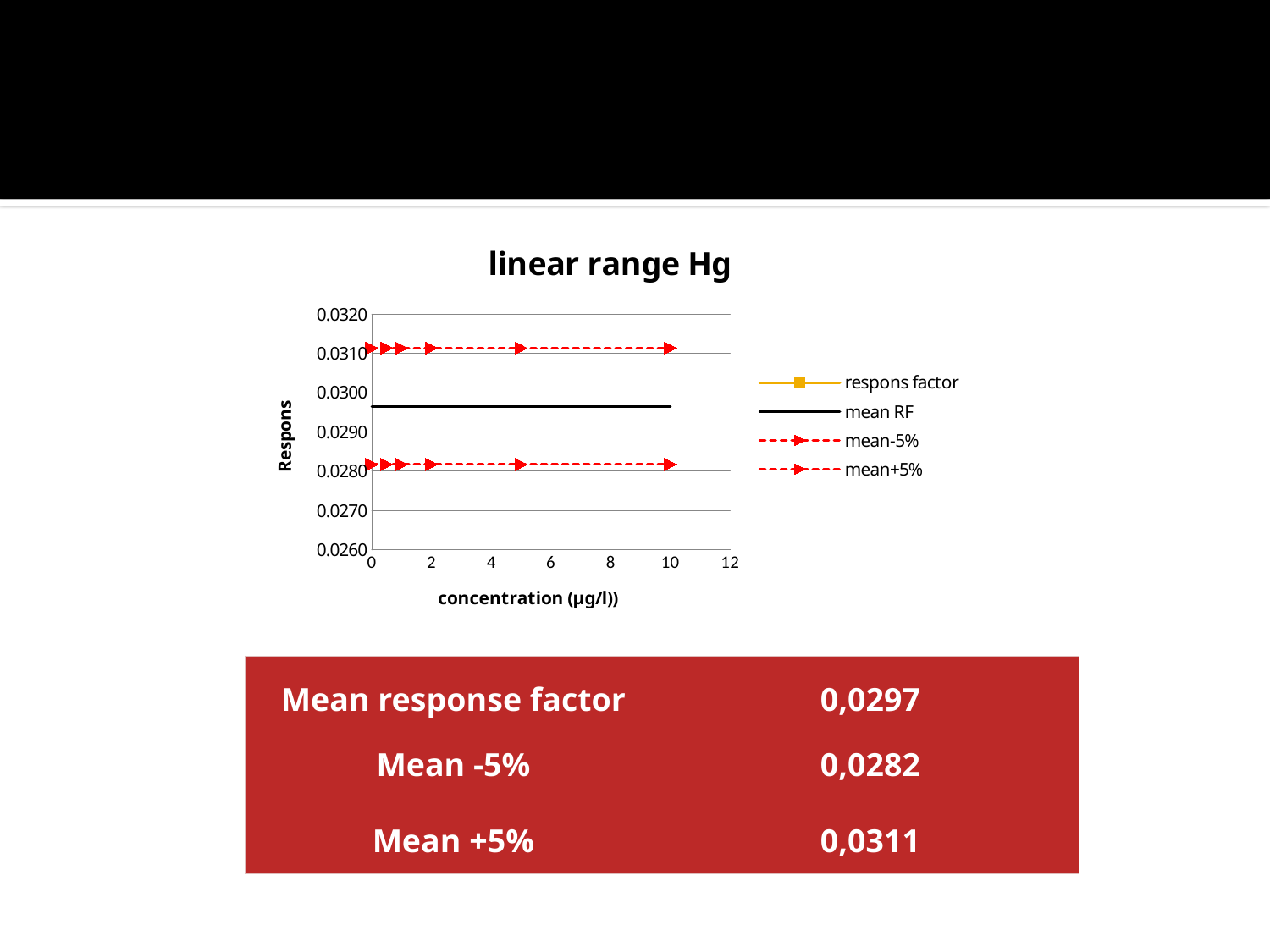
Is the value of the mean+5% line greater or less than 0.0300? greater Which line lies higher on the chart, mean+5% or mean-5%? mean+5% What is the label on the y axis of the chart? Respons How many series does the chart legend list? 4 Is the value of the mean-5% line greater or less than 0.0290? less According to the slide, what is the mean response factor? 0,0297 Is the value of the mean RF line greater or less than 0.0300? less Does the mean RF line rise, fall, or stay flat as concentration increases? stay flat What kind of chart is shown on the slide? line chart What is the title of the chart? linear range Hg According to the slide, what is the difference between the Mean +5% value and the Mean -5% value? 0,0029